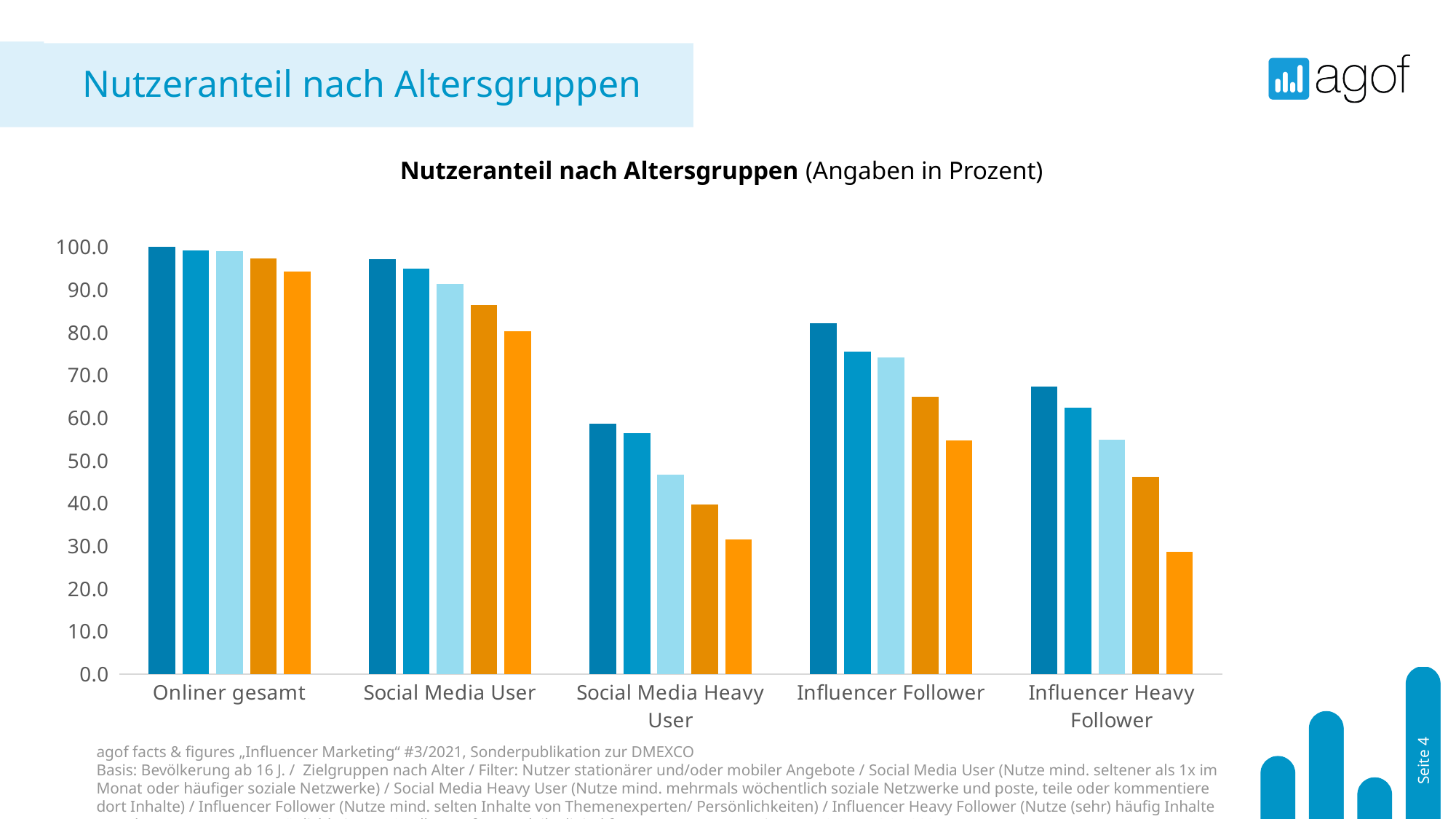
What is the highest tick value shown on the y axis of the chart? 100.0 Which category has the tallest bars overall in the chart? Onliner gesamt Which is larger: the leftmost bar for Social Media Heavy User or the leftmost bar for Influencer Heavy Follower? Influencer Heavy Follower What kind of chart is shown on the slide? bar chart Is the value of the rightmost (orange) bar for Social Media Heavy User greater or less than 40? less How many bars are plotted for each category in the chart? 5 How many categories are shown on the x axis of the chart? 5 Is the value of the rightmost (orange) bar for Influencer Heavy Follower greater or less than 40? less Is the value of the leftmost (dark blue) bar for Influencer Follower greater or less than 70? greater What is the title printed above the chart? Nutzeranteil nach Altersgruppen (Angaben in Prozent)